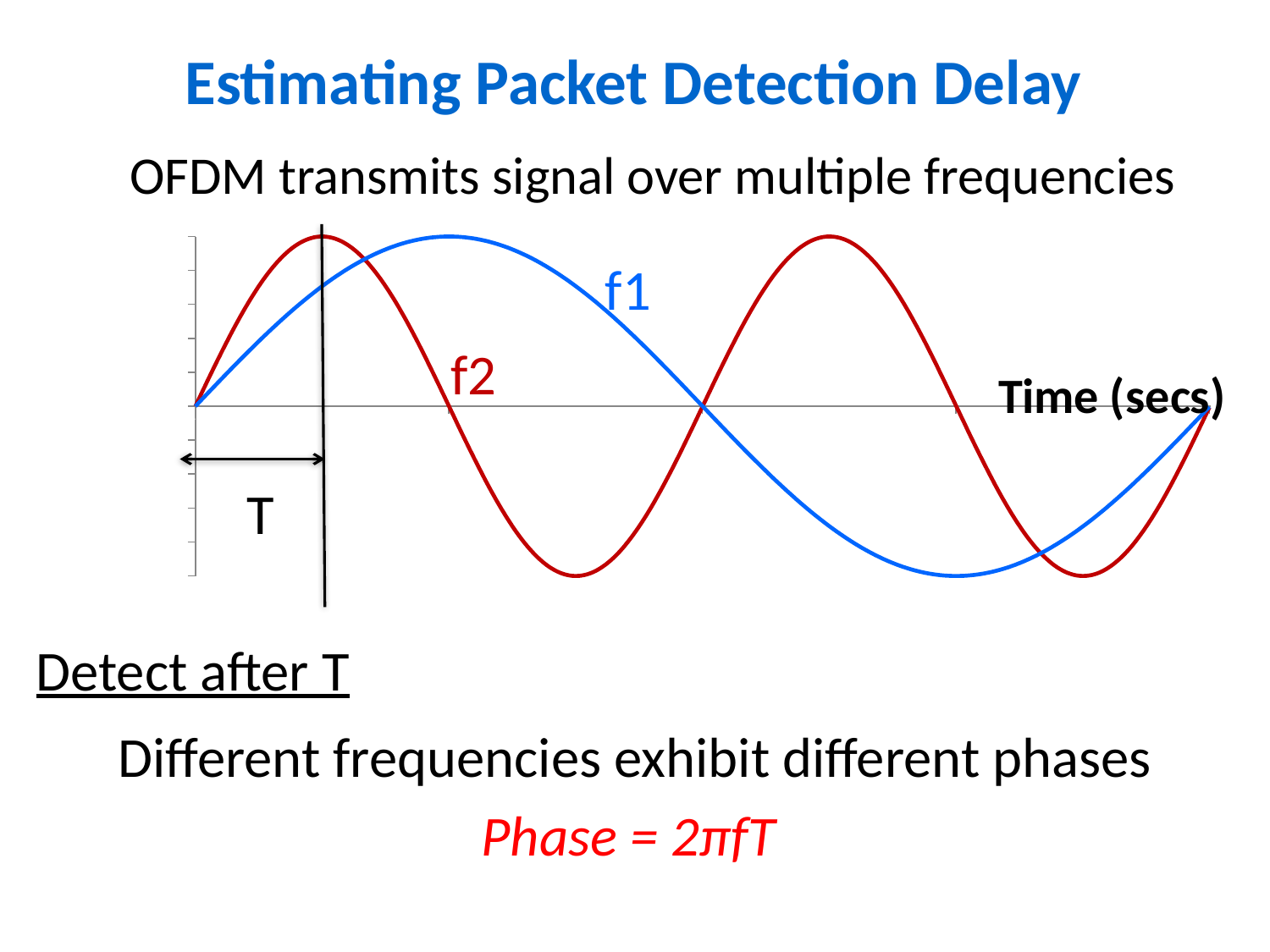
Which curve, f1 or f2, has the lower frequency? f1 Do both curves f1 and f2 start at the same value at time zero? Yes Which curve, f1 or f2, completes more full cycles over the plotted time range? f2 At the vertical line marking time T, which curve, f1 or f2, has the higher value? f2 How many signal curves are plotted on the chart? 2 What kind of chart is shown on the slide? Line chart What are the labels of the two curves plotted on the chart? f1 and f2 What is the label of the horizontal axis of the chart? Time (secs)